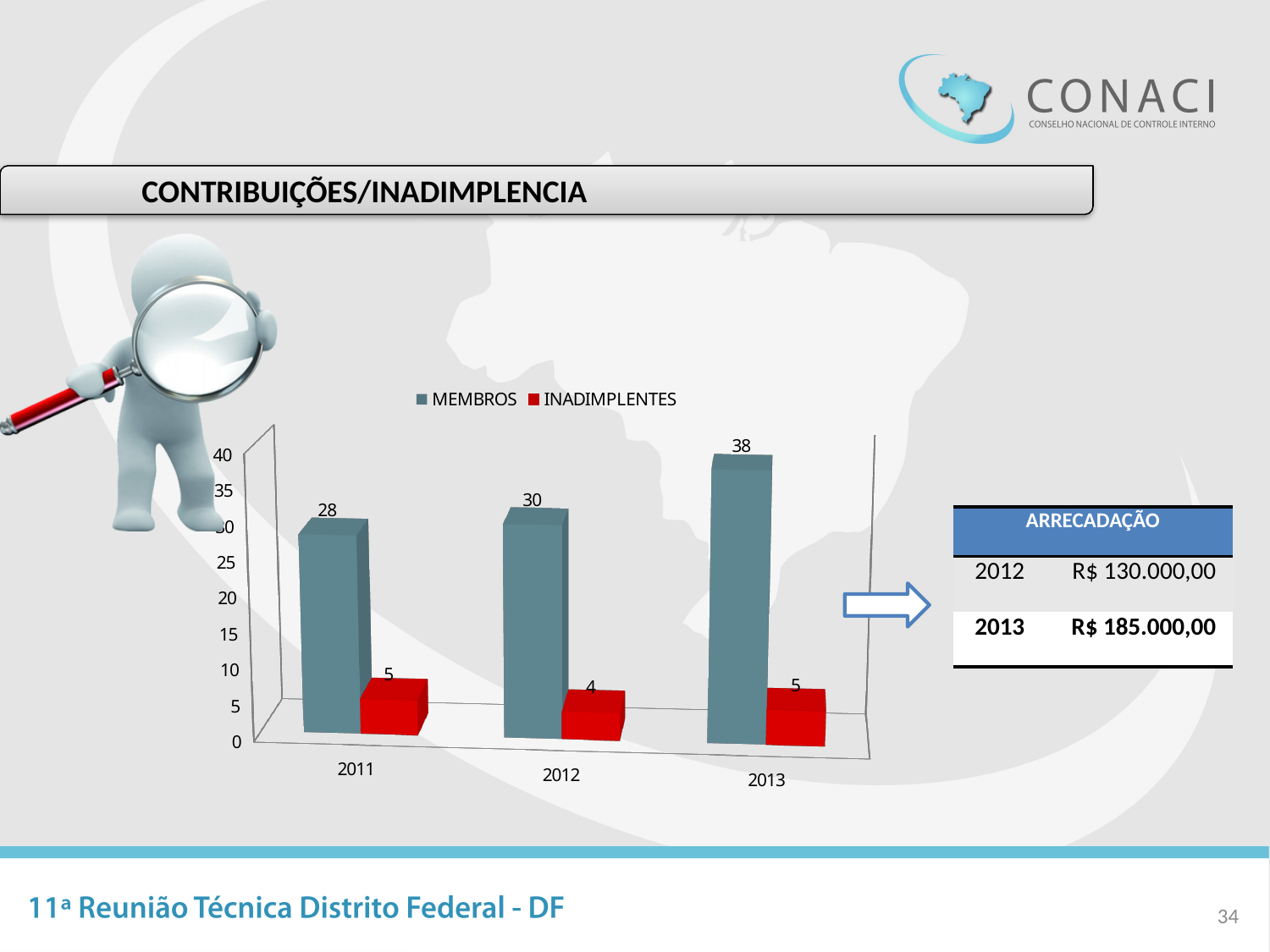
Which year has the highest value for MEMBROS? 2013 Is the value for MEMBROS in 2013 greater or less than 35? greater What is the value for INADIMPLENTES in 2012? 4 Which is larger: MEMBROS in 2012 or MEMBROS in 2011? MEMBROS in 2012 How many series does the chart legend list? 2 How many years are shown on the x axis of the chart? 3 What is the value for MEMBROS in 2013? 38 What is the value for MEMBROS in 2011? 28 Which year has the lowest value for INADIMPLENTES? 2012 What is the difference between MEMBROS in 2013 and MEMBROS in 2011? 10 What kind of chart is shown on the slide? bar chart Do the MEMBROS values rise or fall from 2011 to 2013? rise